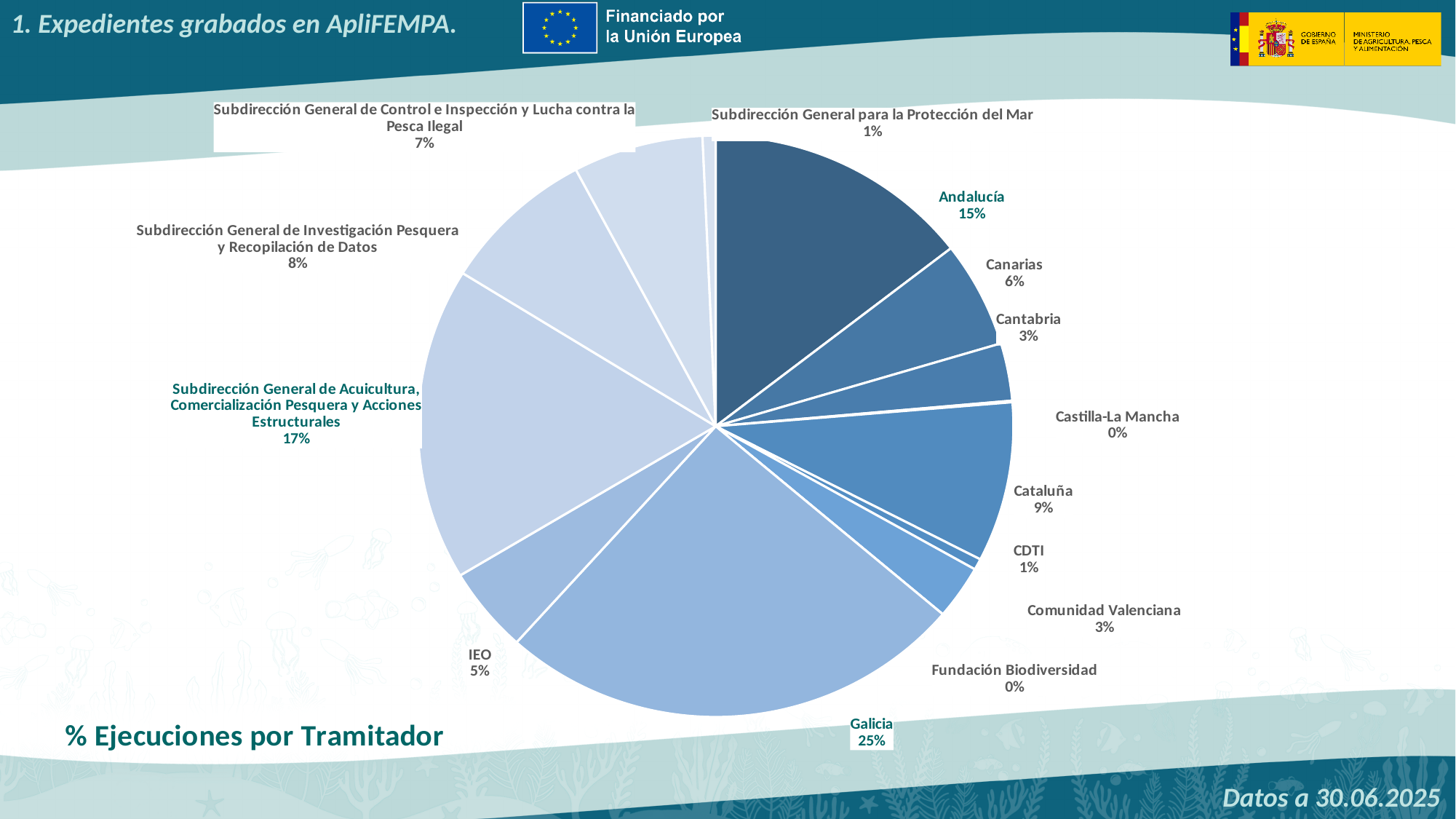
What share of the pie does Galicia have? 25% What is the difference between the values for Galicia and Andalucía? 10% What is the value for Cataluña? 9% Which category has the largest slice of the pie? Galicia What kind of chart is shown on the slide? Pie chart What is the title of the chart? % Ejecuciones por Tramitador What is the difference between the values for Subdirección General de Acuicultura, Comercialización Pesquera y Acciones Estructurales and Subdirección General de Control e Inspección y Lucha contra la Pesca Ilegal? 10% Which is larger, the value for Canarias or the value for IEO? Canarias What is the value for Subdirección General de Acuicultura, Comercialización Pesquera y Acciones Estructurales? 17% What is the value for Subdirección General de Investigación Pesquera y Recopilación de Datos? 8% What is the value for Andalucía? 15% How many categories are shown in the pie chart? 14